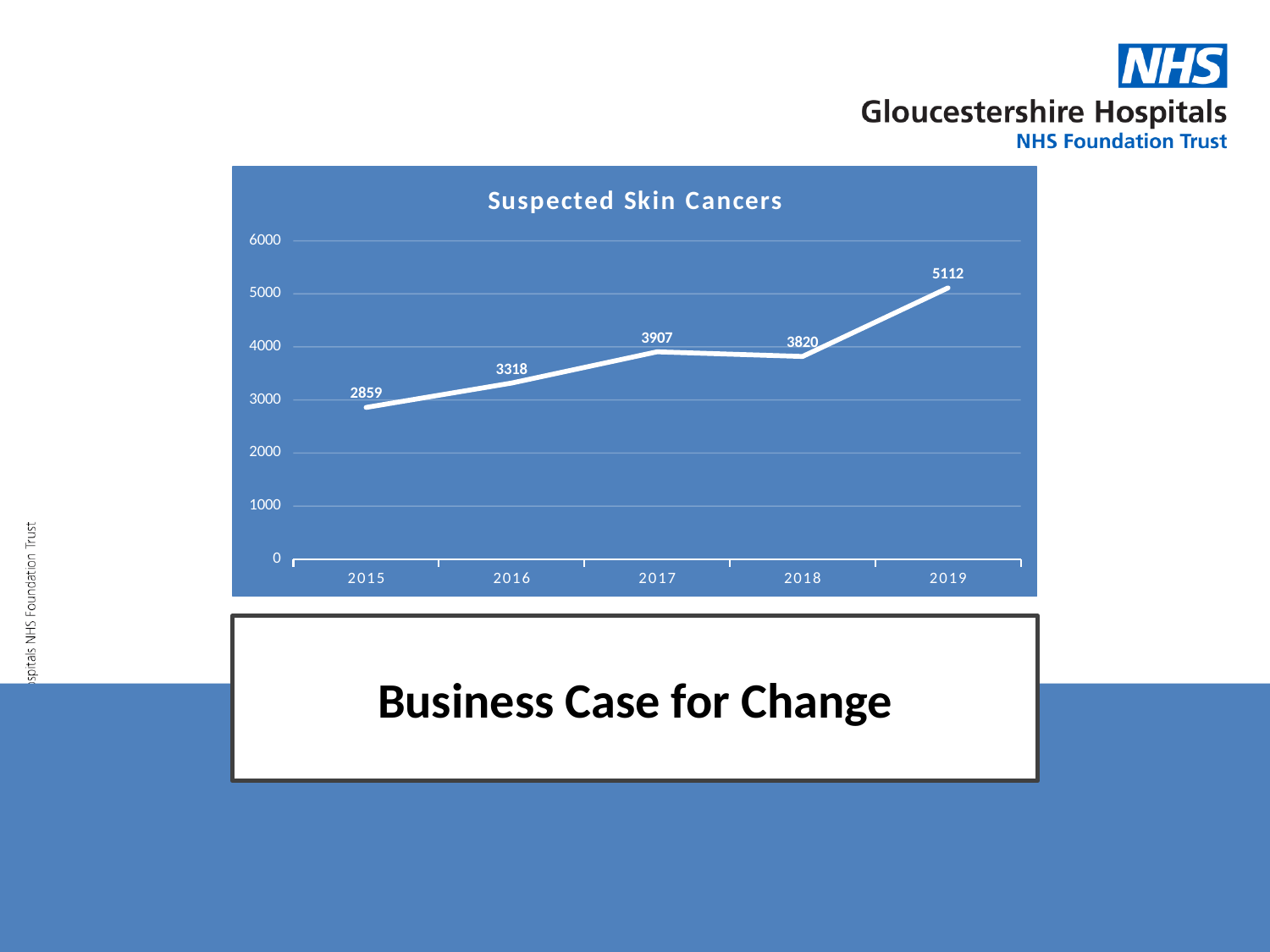
What is the value for 2019 in the Suspected Skin Cancers chart? 5112 How many years are plotted in the Suspected Skin Cancers chart? 5 What is the difference between the 2019 and 2015 values in the Suspected Skin Cancers chart? 2253 Which year has the lowest value in the Suspected Skin Cancers chart? 2015 Is the value for 2016 in the Suspected Skin Cancers chart greater or less than 3000? greater Which year has the highest value in the Suspected Skin Cancers chart? 2019 What is the difference between the 2017 and 2018 values in the Suspected Skin Cancers chart? 87 What is the value for 2015 in the Suspected Skin Cancers chart? 2859 What is the title of the chart on the slide? Suspected Skin Cancers What is the value for 2017 in the Suspected Skin Cancers chart? 3907 Which is larger in the Suspected Skin Cancers chart, the value for 2016 or the value for 2018? 2018 What kind of chart is the Suspected Skin Cancers chart? line chart